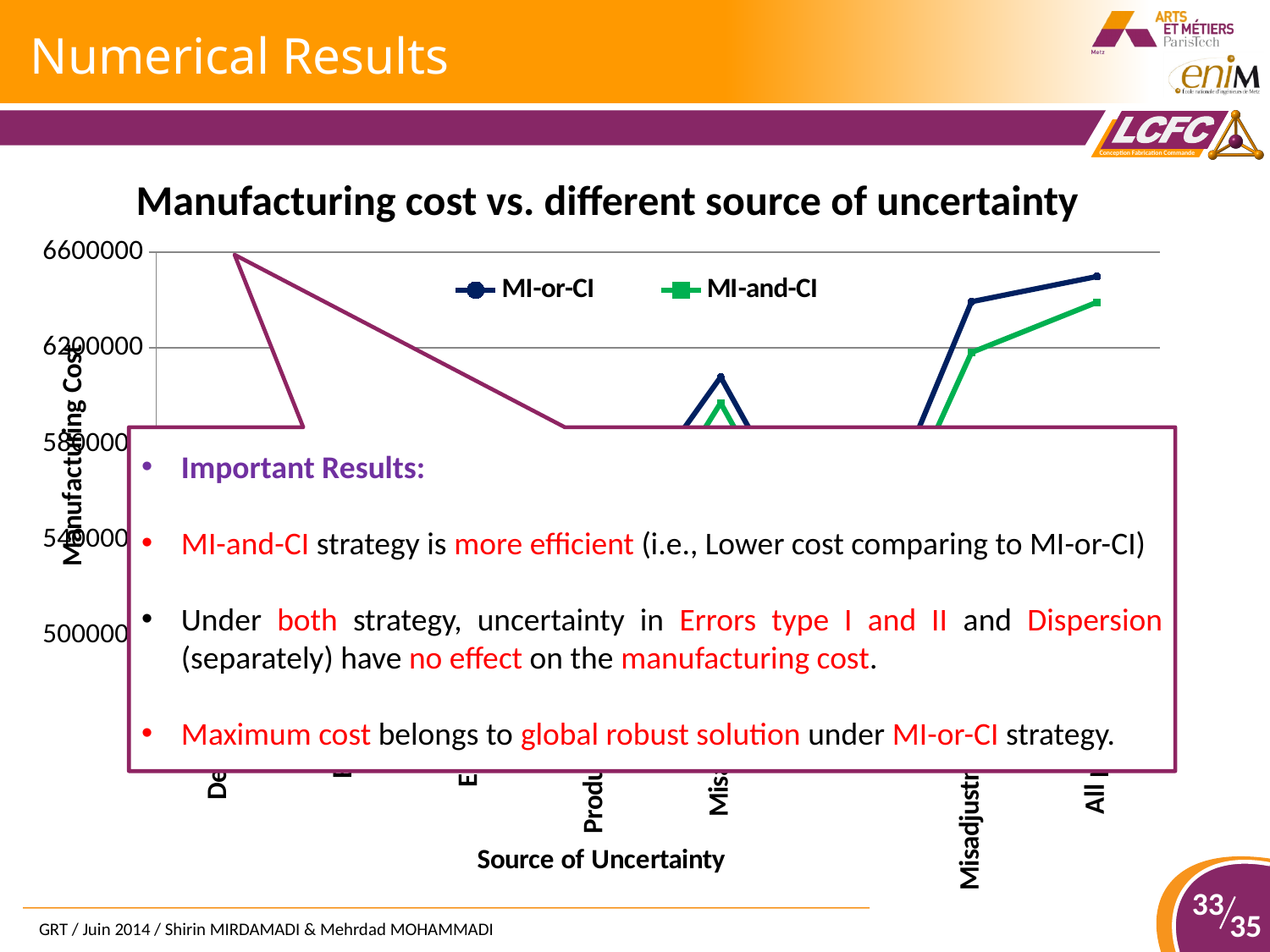
How many series does the chart's legend list? 2 Is the MI-or-CI value at the rightmost category greater or less than 6600000? less What is the label of the chart's vertical axis? Manufacturing Cost What is the label of the chart's horizontal axis? Source of Uncertainty What are the two series named in the chart's legend? MI-or-CI and MI-and-CI Is the MI-and-CI value at the rightmost category greater or less than 6200000? greater What kind of chart is shown on the slide? line chart Is the MI-or-CI value at the rightmost category greater or less than 6200000? greater At the rightmost category on the x axis, which series has the higher manufacturing cost, MI-or-CI or MI-and-CI? MI-or-CI